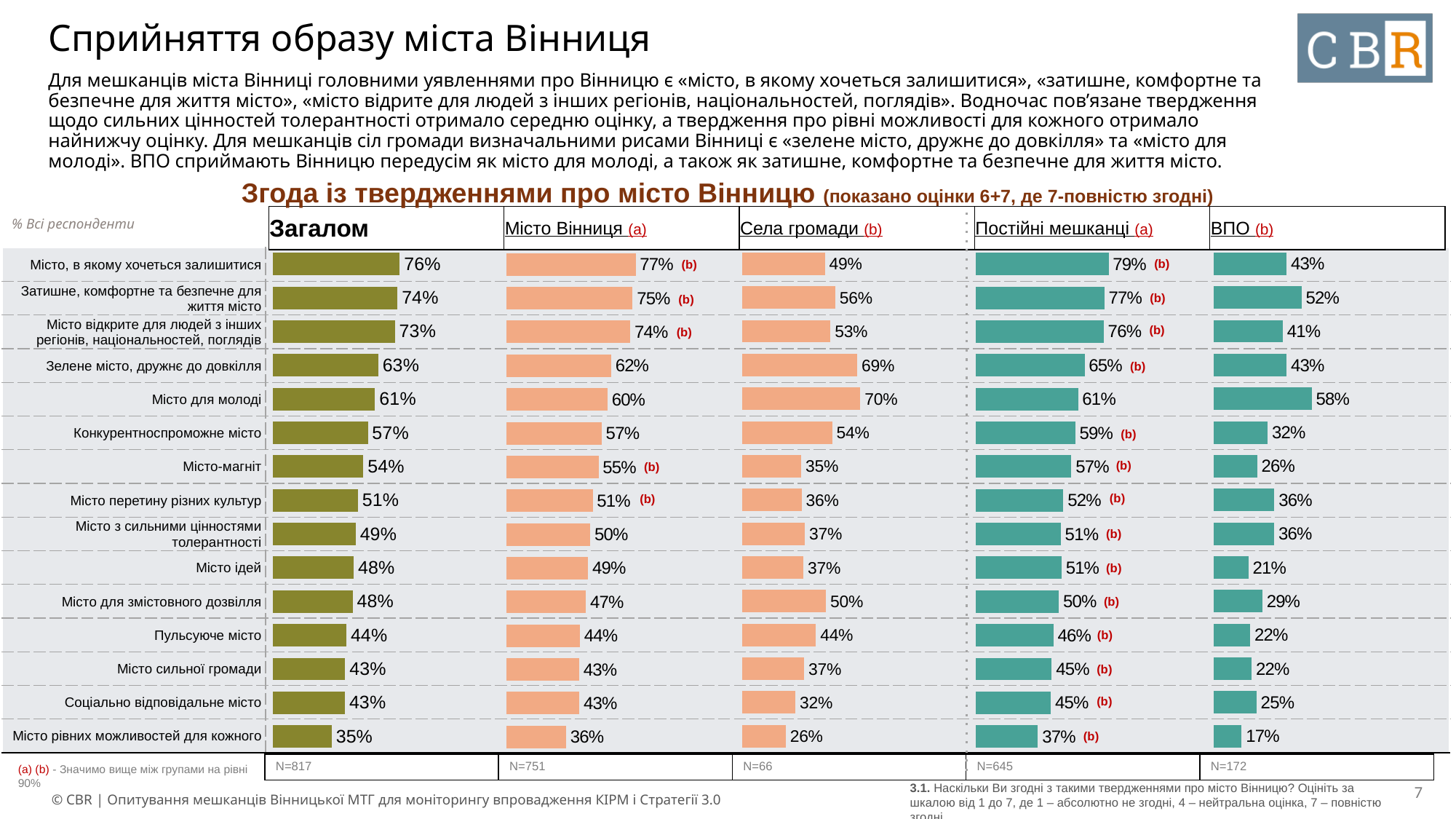
In the 'Загалом' column, do the values rise or fall from the top statement to the bottom statement? Fall For 'Зелене місто, дружнє до довкілля', which is larger: the 'Місто Вінниця' value or the 'Села громади' value? Села громади In the 'ВПО' column, what is the value for 'Місто для молоді'? 58% What type of chart is used on this slide? Bar chart How many respondent groups (columns of bars) does the chart show? 5 In the 'Села громади' column, which statement has the highest value? Місто для молоді How many statements about Vinnytsia are listed in the chart? 15 What is the sample size (N) for the 'Села громади' group? N=66 What is the difference between the 'Постійні мешканці' and 'ВПО' values for 'Місто, в якому хочеться залишитися'? 36 percentage points In the 'Місто Вінниця' column, what is the value for 'Місто-магніт'? 55% In the 'ВПО' column, which statement has the lowest value? Місто рівних можливостей для кожного In the 'Загалом' column, what is the value for 'Місто, в якому хочеться залишитися'? 76%